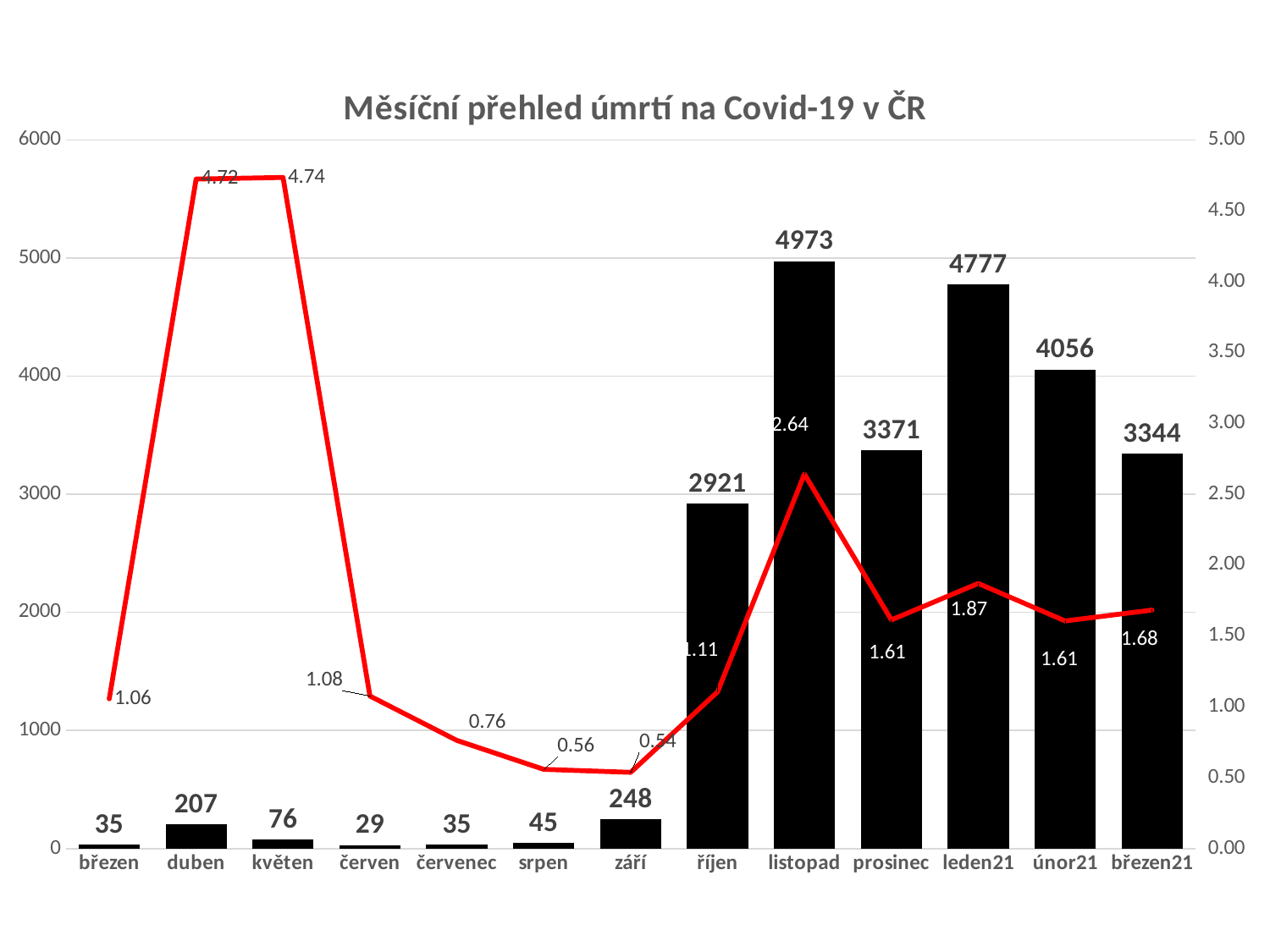
What is the bar value for říjen? 2921 What is the title of the chart? Měsíční přehled úmrtí na Covid-19 v ČR What is the red line value for září? 0.54 Which month has the lowest bar? červen What is the bar value for listopad? 4973 How many months are shown on the x axis? 13 Which month has the highest bar? listopad What kind of chart is this? Combined bar and line chart What is the red line value for duben? 4.72 Is the bar value for prosinec greater or less than 3000? greater Which has a larger bar value, únor21 or březen21? únor21 What is the difference between the bar values for listopad and leden21? 196